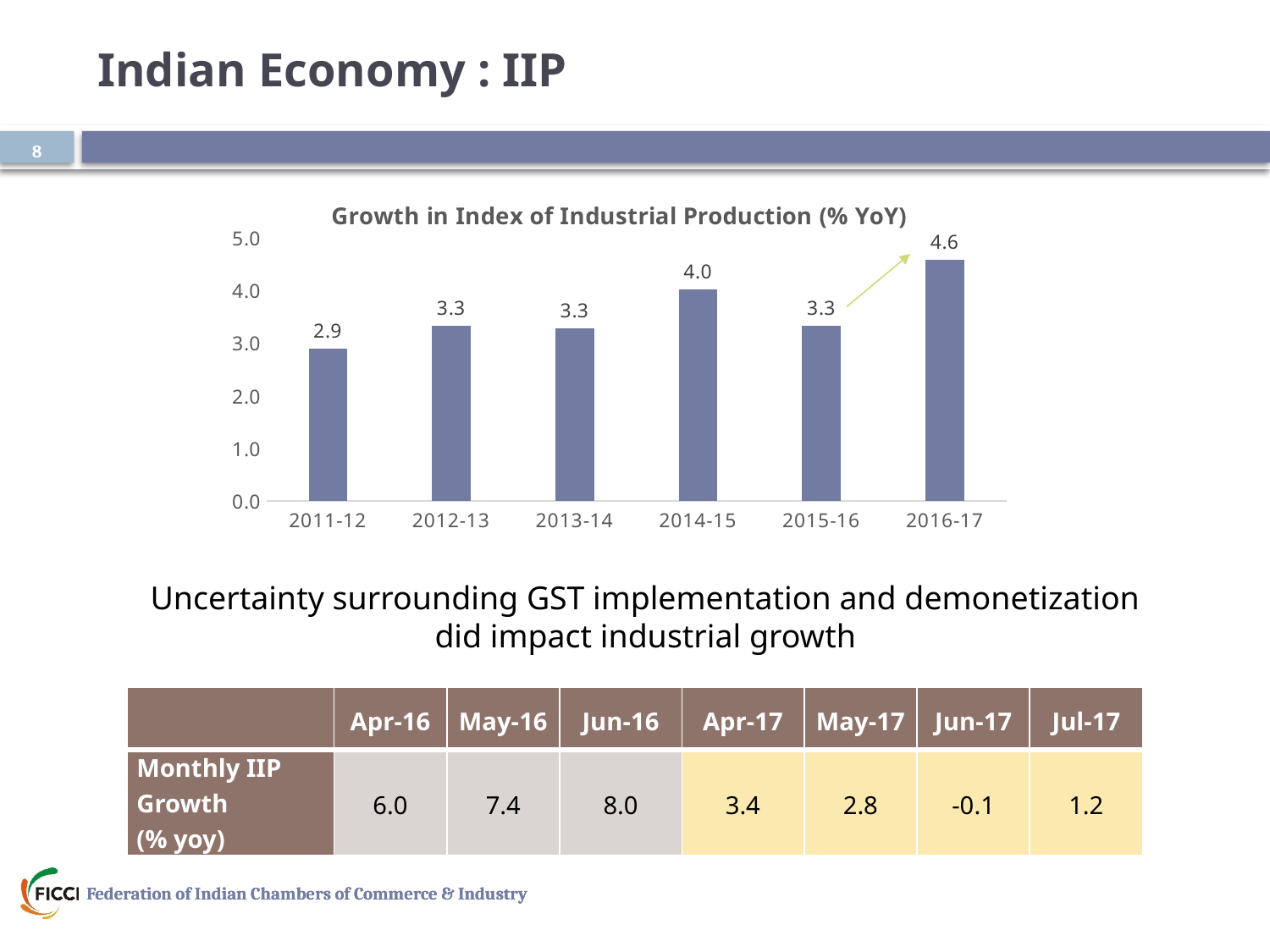
How many years are shown in the Growth in Index of Industrial Production chart? 6 What is the value for 2011-12 in the Growth in Index of Industrial Production chart? 2.9 What is the value for 2014-15 in the Growth in Index of Industrial Production chart? 4.0 What is the value for 2016-17 in the Growth in Index of Industrial Production chart? 4.6 Which year has the highest value in the Growth in Index of Industrial Production chart? 2016-17 What is the difference between the values for 2014-15 and 2011-12 in the Growth in Index of Industrial Production chart? 1.1 Is the value for 2016-17 in the Growth in Index of Industrial Production chart greater or less than 4.0? greater What is the title of the chart on the slide? Growth in Index of Industrial Production (% YoY) What is the difference between the values for 2016-17 and 2015-16 in the Growth in Index of Industrial Production chart? 1.3 Which is larger in the Growth in Index of Industrial Production chart, the value for 2014-15 or 2015-16? 2014-15 What kind of chart is the Growth in Index of Industrial Production chart? bar chart Which year has the lowest value in the Growth in Index of Industrial Production chart? 2011-12